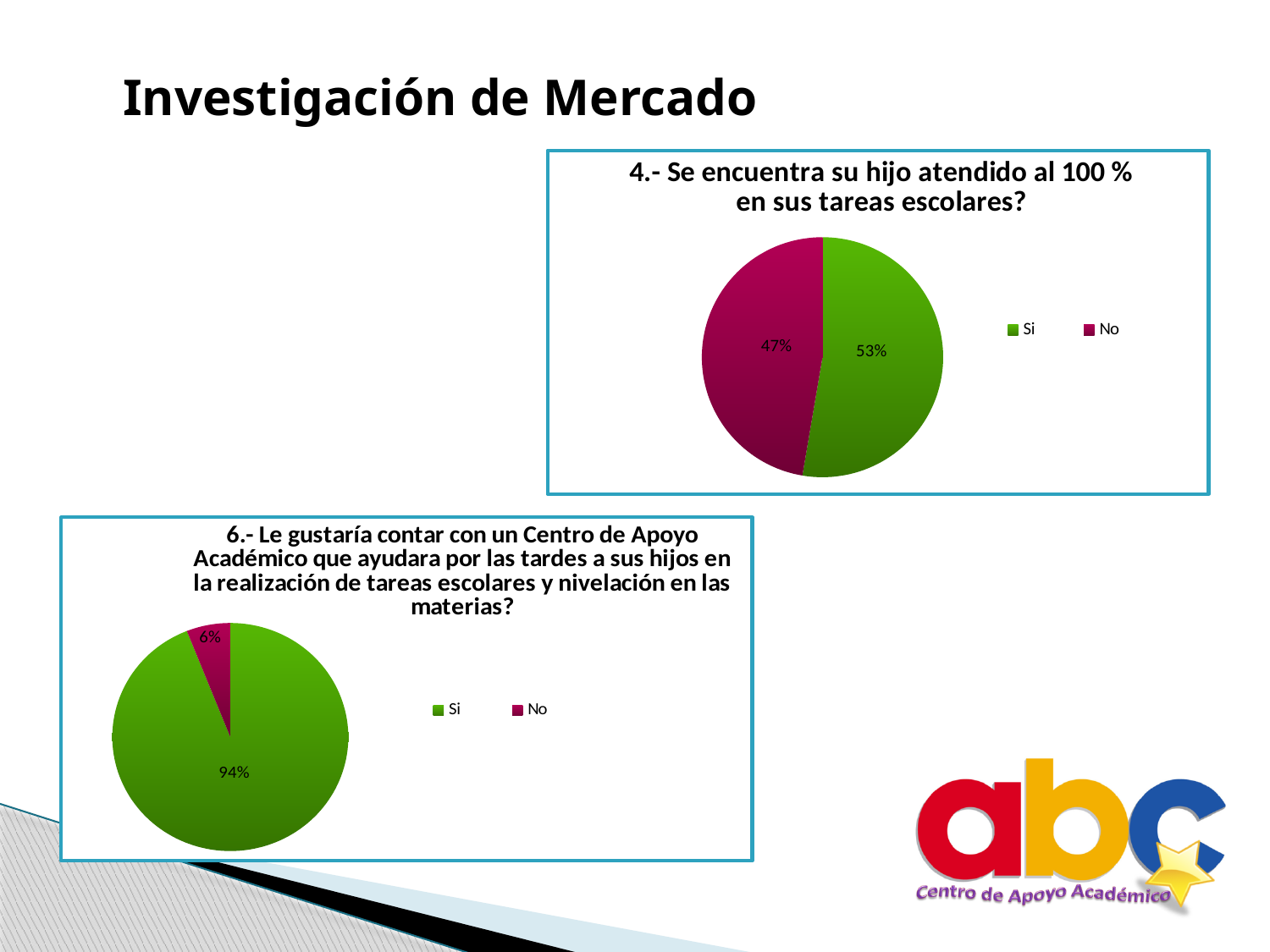
In the top-right chart (question 4), what percentage answered Si? 53% How many slices does the bottom-left chart (question 6) have? 2 In the bottom-left chart (question 6), what percentage answered Si? 94% In the bottom-left chart (question 6), what percentage answered No? 6% In the top-right chart (question 4), what percentage answered No? 47% Is the No share larger in the top-right chart (question 4) or the bottom-left chart (question 6)? Top-right chart (question 4) What type of chart is used for question 4 on the slide? Pie chart In the top-right chart (question 4), which colour represents the No response? Magenta/purple In the top-right chart (question 4), which response has the larger share? Si In the bottom-left chart (question 6), what is the difference between the Si and No shares? 88% In the bottom-left chart (question 6), which response has the smallest share? No In the top-right chart (question 4), what is the difference between the Si and No shares? 6%